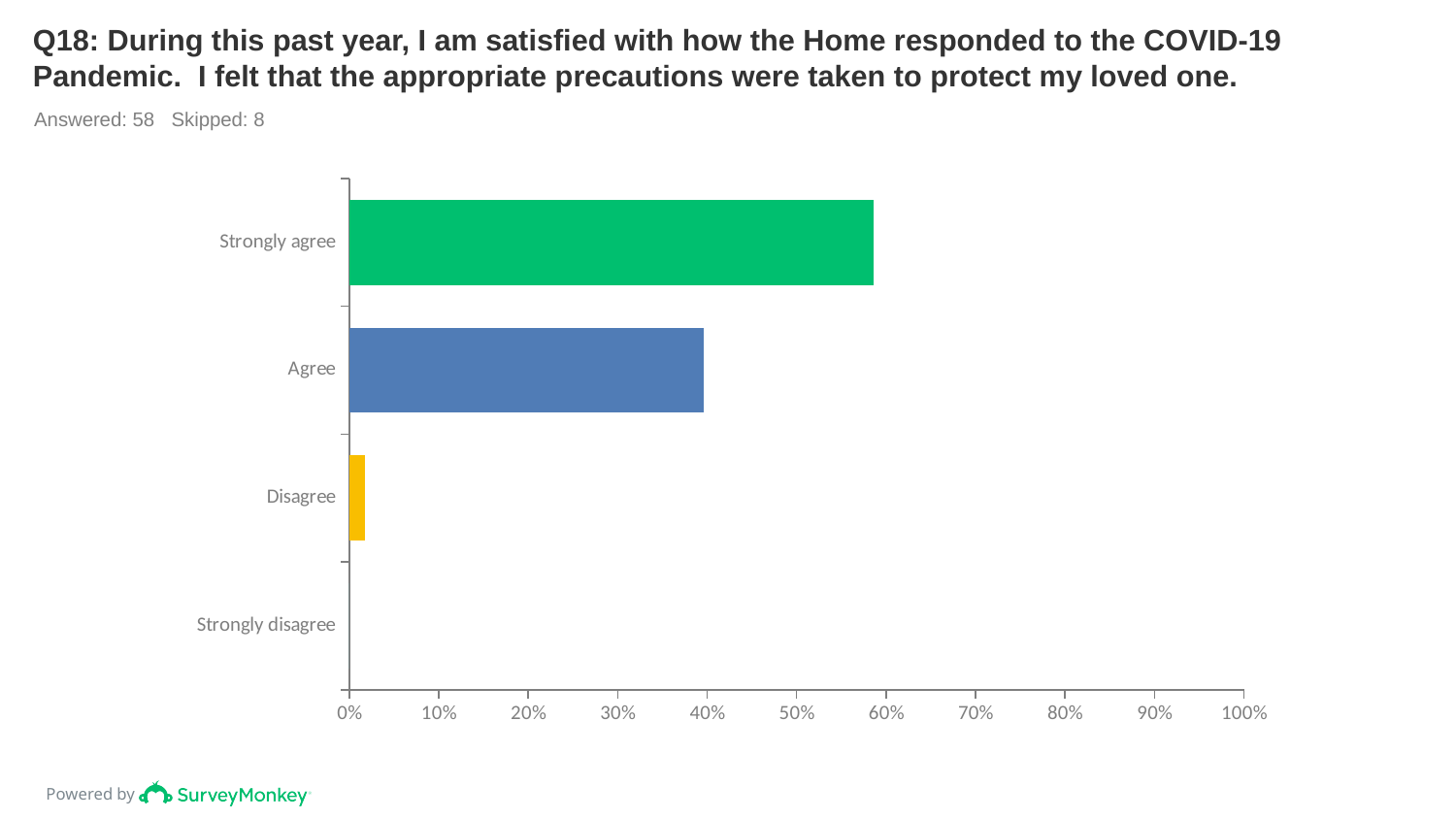
How many response categories are shown on the chart? 4 What kind of chart is shown on the slide? bar chart Is the value for Disagree greater or less than 10%? less Which response category has the highest value? Strongly agree Which is larger, the value for Strongly agree or the value for Agree? Strongly agree Which is larger, the value for Agree or the value for Disagree? Agree Which response category has the lowest value? Strongly disagree Is the value for Strongly agree greater or less than 60%? less What colour is the bar for Disagree? yellow How many respondents answered this question according to the slide? 58 Is the value for Strongly agree greater or less than 50%? greater